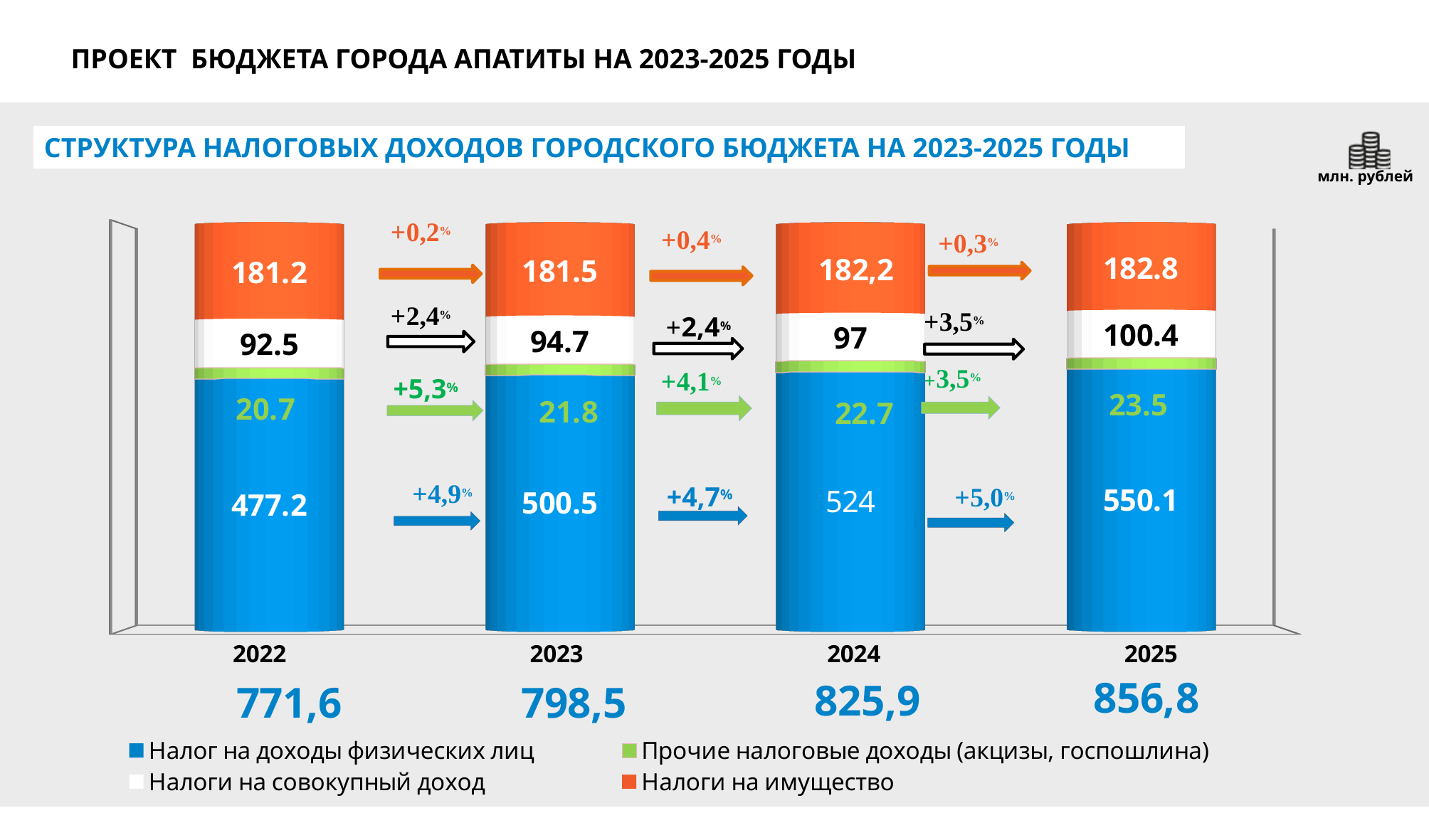
What is the total tax revenue shown for 2023? 798,5 What is the value of Прочие налоговые доходы (акцизы, госпошлина) for 2025? 23.5 In 2024, which is larger: Налоги на имущество or Налоги на совокупный доход? Налоги на имущество What is the difference between Налог на доходы физических лиц in 2025 and in 2022? 72.9 What is the value of Налоги на имущество for 2024? 182,2 How many years are shown on the x axis? 4 What kind of chart is shown on the slide? Stacked bar chart What is the value of Налог на доходы физических лиц for 2022? 477.2 How many series does the legend list? 4 What is the value of Налоги на совокупный доход for 2023? 94.7 Which year has the highest total tax revenue? 2025 Which year has the lowest total tax revenue? 2022